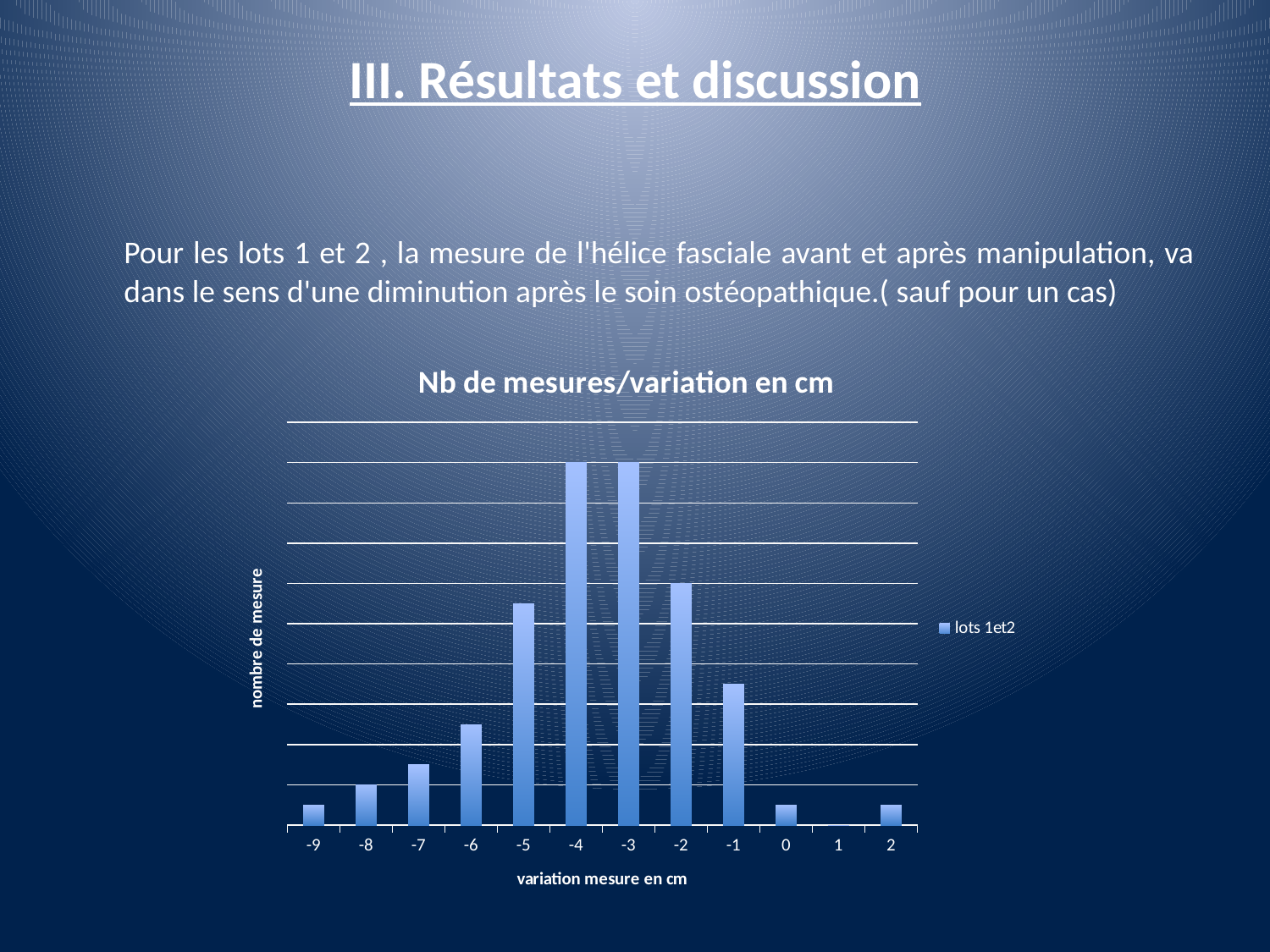
Which has the larger value, -7 or -6? -6 Do the values rise or fall along the x axis from -3 to 1? fall What series does the chart legend list? lots 1et2 Do the values rise or fall along the x axis from -9 to -4? rise How many series does the legend list? 1 What is the title of the chart? Nb de mesures/variation en cm What kind of chart is shown on the slide? bar chart Which has the larger value, -2 or -1? -2 How many categories are shown on the x axis of the chart? 12 Which category has the lowest value in the chart? 1 Which has the larger value, -9 or -8? -8